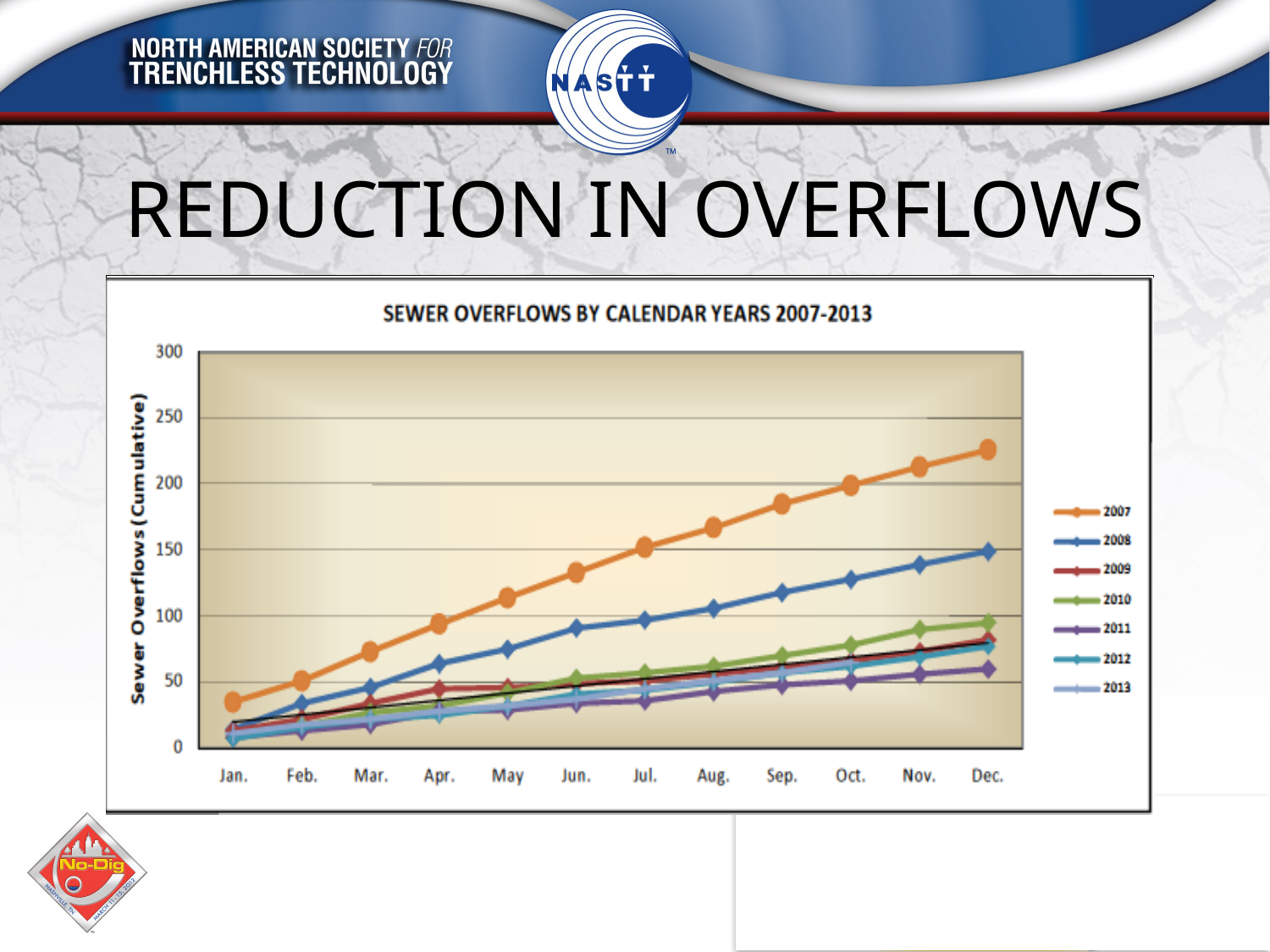
What is the label on the y axis? Sewer Overflows (Cumulative) Do the values for 2007 rise or fall from January to December? rise Is the December value for 2008 greater or less than 100? greater Which year has the highest cumulative overflows in December? 2007 Is the December value for 2007 greater or less than 200? greater Which year has the lowest cumulative overflows in December? 2011 Is the December value for 2011 greater or less than 100? less What is the title of the chart? SEWER OVERFLOWS BY CALENDAR YEARS 2007-2013 How many series does the legend list? 7 What kind of chart is shown on the slide? line chart In December, which is larger: the value for 2007 or the value for 2008? 2007 How many months are shown along the x axis? 12